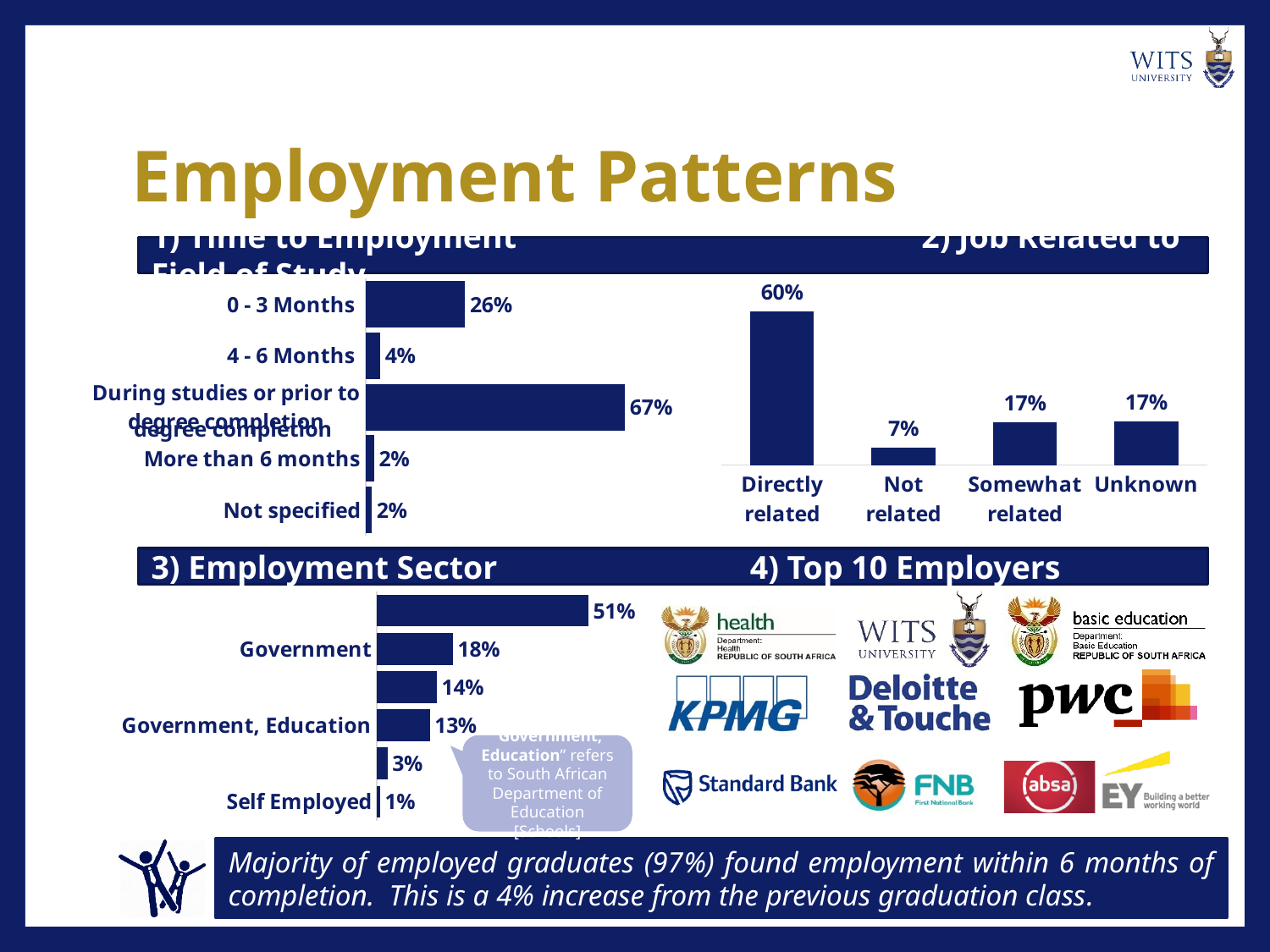
In the Time to Employment chart, what percentage of graduates found employment within 0 - 3 months? 26% In the Time to Employment chart, what is the value for 4 - 6 Months? 4% In the Employment Sector chart, what is the value for Government? 18% In the Job Related to Field of Study chart, what is the difference between Directly related and Somewhat related? 43% In the Employment Sector chart, what is the value for Self Employed? 1% In the Employment Sector chart, which is larger: Government or Government, Education? Government What kind of chart is the Job Related to Field of Study chart? Bar chart How many categories are shown in the Time to Employment chart? 5 In the Time to Employment chart, which category has the highest value? During studies or prior to degree completion In the Time to Employment chart, what is the difference between the values for 0 - 3 Months and 4 - 6 Months? 22% In the Job Related to Field of Study chart, which category has the lowest value? Not related In the Job Related to Field of Study chart, what percentage of jobs are Directly related? 60%